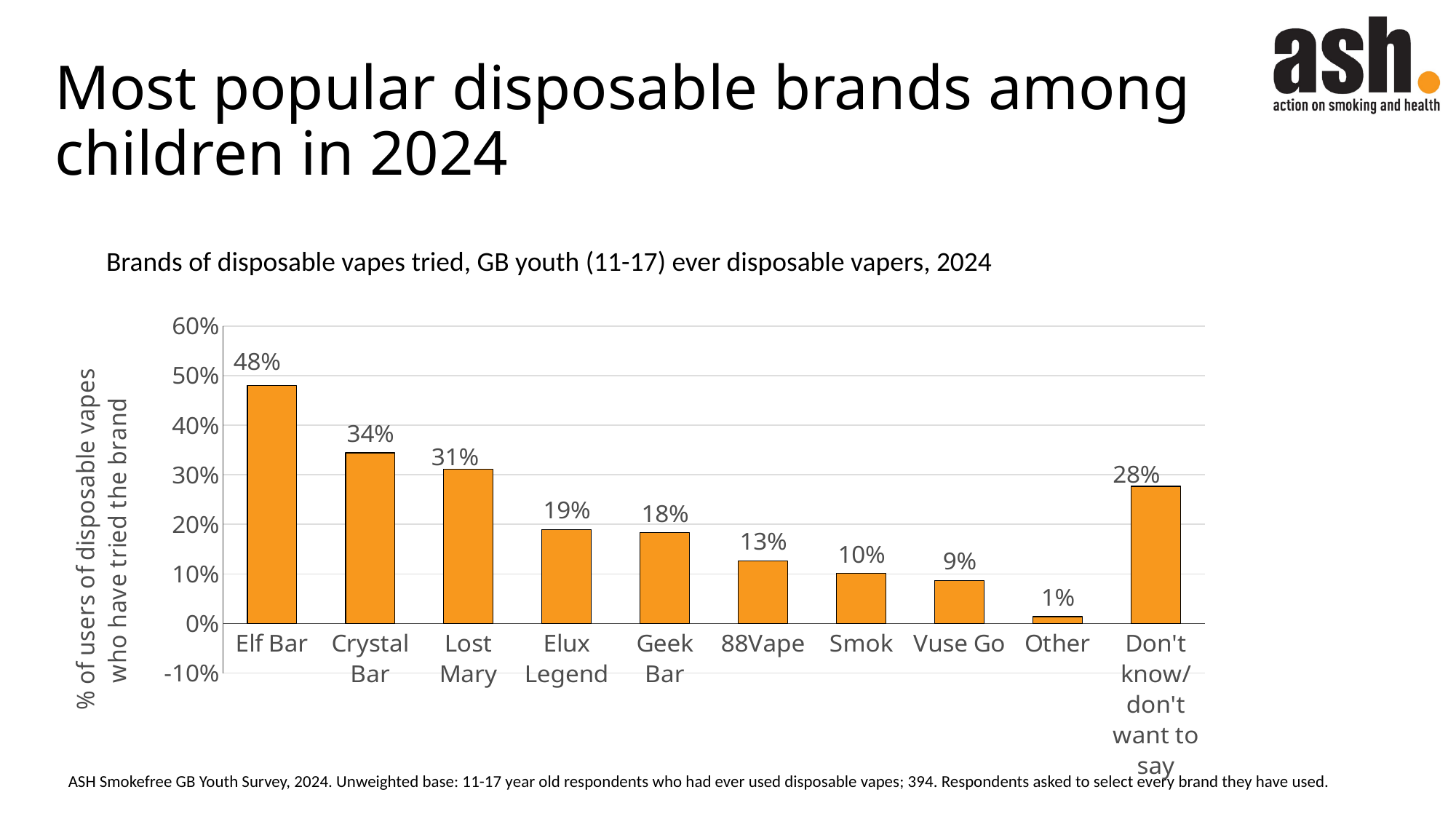
What percentage is shown for Vuse Go? 9% Which brand has the highest percentage of users who have tried it? Elf Bar What is the difference between the values for Elf Bar and Crystal Bar? 14% Which category has the lowest value on the chart? Other What is the value for the 'Don't know/ don't want to say' category? 28% How many categories are shown on the x axis of the chart? 10 What is the difference between the values for Lost Mary and Elux Legend? 12% What is the title of the chart? Brands of disposable vapes tried, GB youth (11-17) ever disposable vapers, 2024 What type of chart is shown on the slide? Bar chart Which has a higher value, Geek Bar or 88Vape? Geek Bar What is the value shown for Crystal Bar? 34% What percentage of users of disposable vapes have tried Elf Bar? 48%